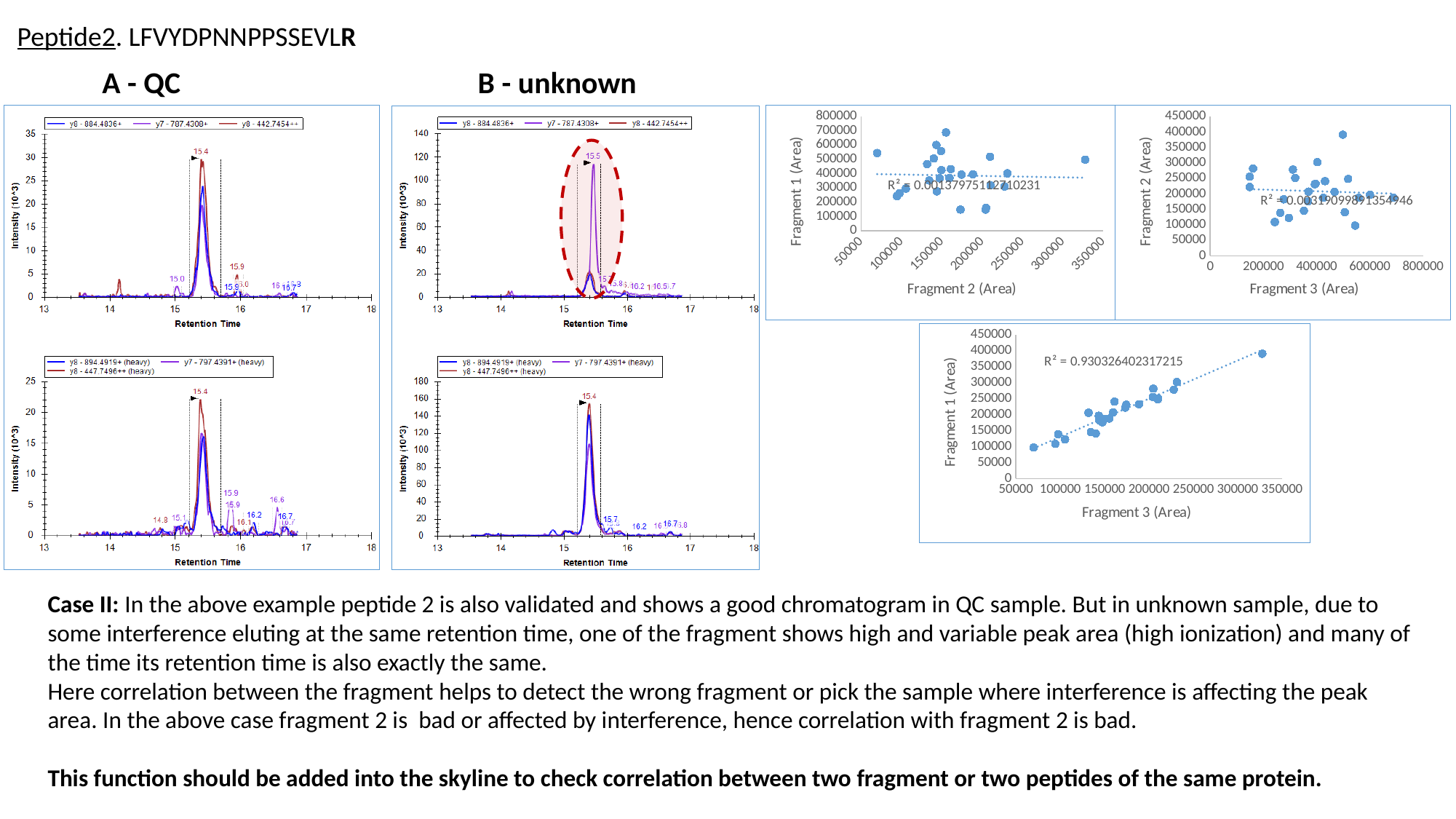
In the bottom-right scatter chart, what is the highest tick shown on the Fragment 3 (Area) axis? 350000 What kind of chart is the bottom-right chart plotting Fragment 1 (Area) against Fragment 3 (Area)? scatter chart What is the x-axis label of the top-left scatter chart (the one with Fragment 1 (Area) on the y-axis)? Fragment 2 (Area) What kind of chart are the chromatograms in panels A - QC and B - unknown? line chart In the bottom-right scatter chart of Fragment 1 (Area) versus Fragment 3 (Area), do the points rise or fall as Fragment 3 (Area) increases? rise In the top chromatogram of panel A - QC, what retention time is labeled at the main peak? 15.4 How many series does the legend list in the top chromatogram of panel A - QC? 3 In the top chromatogram of panel B - unknown, what retention time is labeled at the circled main peak? 15.5 In the bottom-right scatter chart, what is the highest tick shown on the Fragment 1 (Area) axis? 450000 What is the x-axis label of the chromatograms in panels A - QC and B - unknown? Retention Time In the bottom-right scatter chart of Fragment 1 (Area) versus Fragment 3 (Area), what R² value is printed? R² = 0.930326402317215 Among the three scatter charts on the right, which pair of fragments shows the highest R² value? Fragment 1 (Area) versus Fragment 3 (Area)